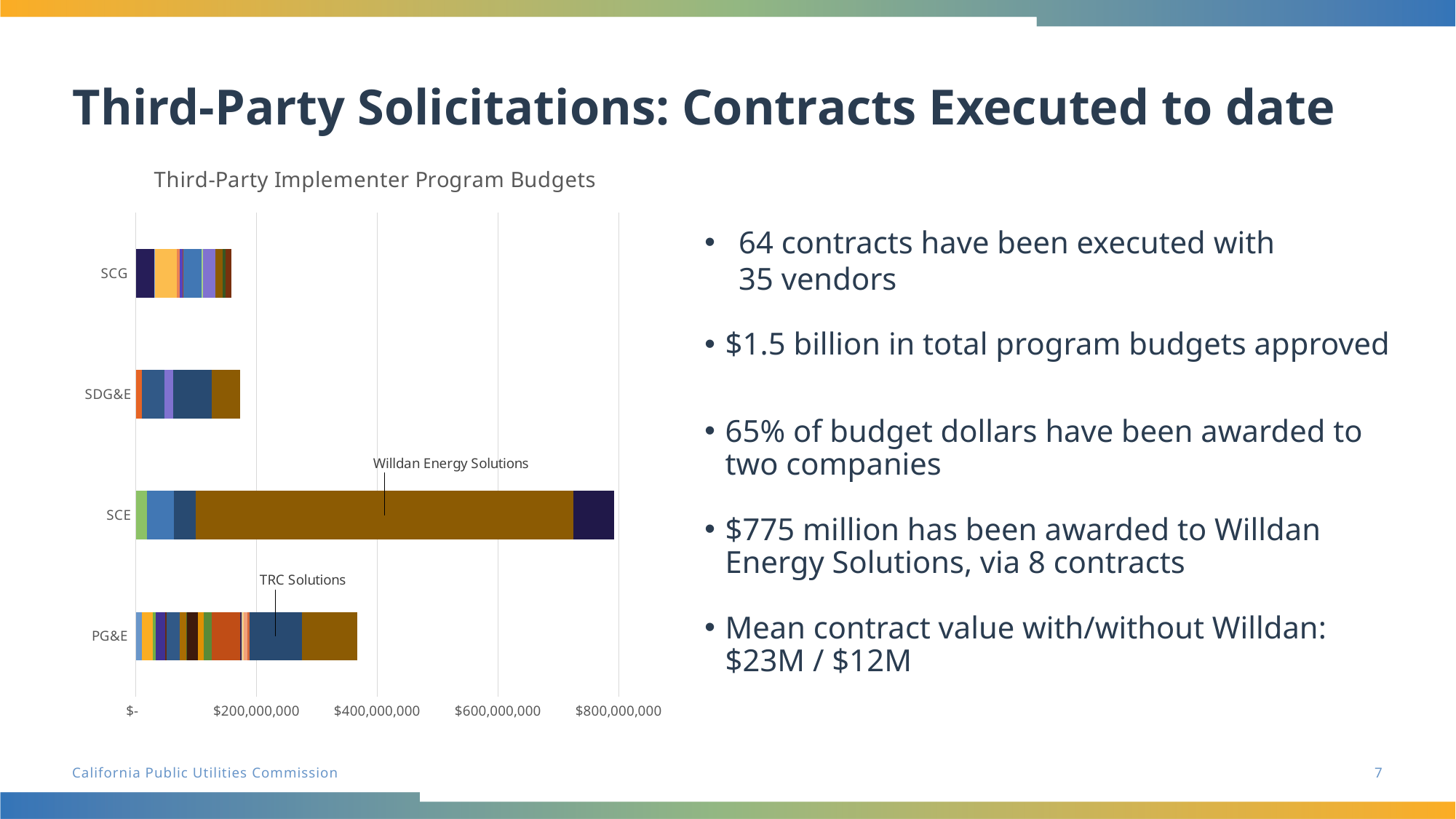
Is the total value for SDG&E greater or less than $200,000,000? less Which implementer is labelled on the largest segment of the SCE bar? Willdan Energy Solutions What kind of chart is shown on the slide? Stacked bar chart Which has a larger total program budget, PG&E or SDG&E? PG&E Is the total value for PG&E greater or less than $200,000,000? greater What is the title of the chart? Third-Party Implementer Program Budgets Is the total value for SCE greater or less than $600,000,000? greater Which utility has the largest total program budget? SCE How many utilities (categories) are shown on the chart? 4 Which utility has the smallest total program budget? SCG Which has a larger total program budget, SCE or PG&E? SCE